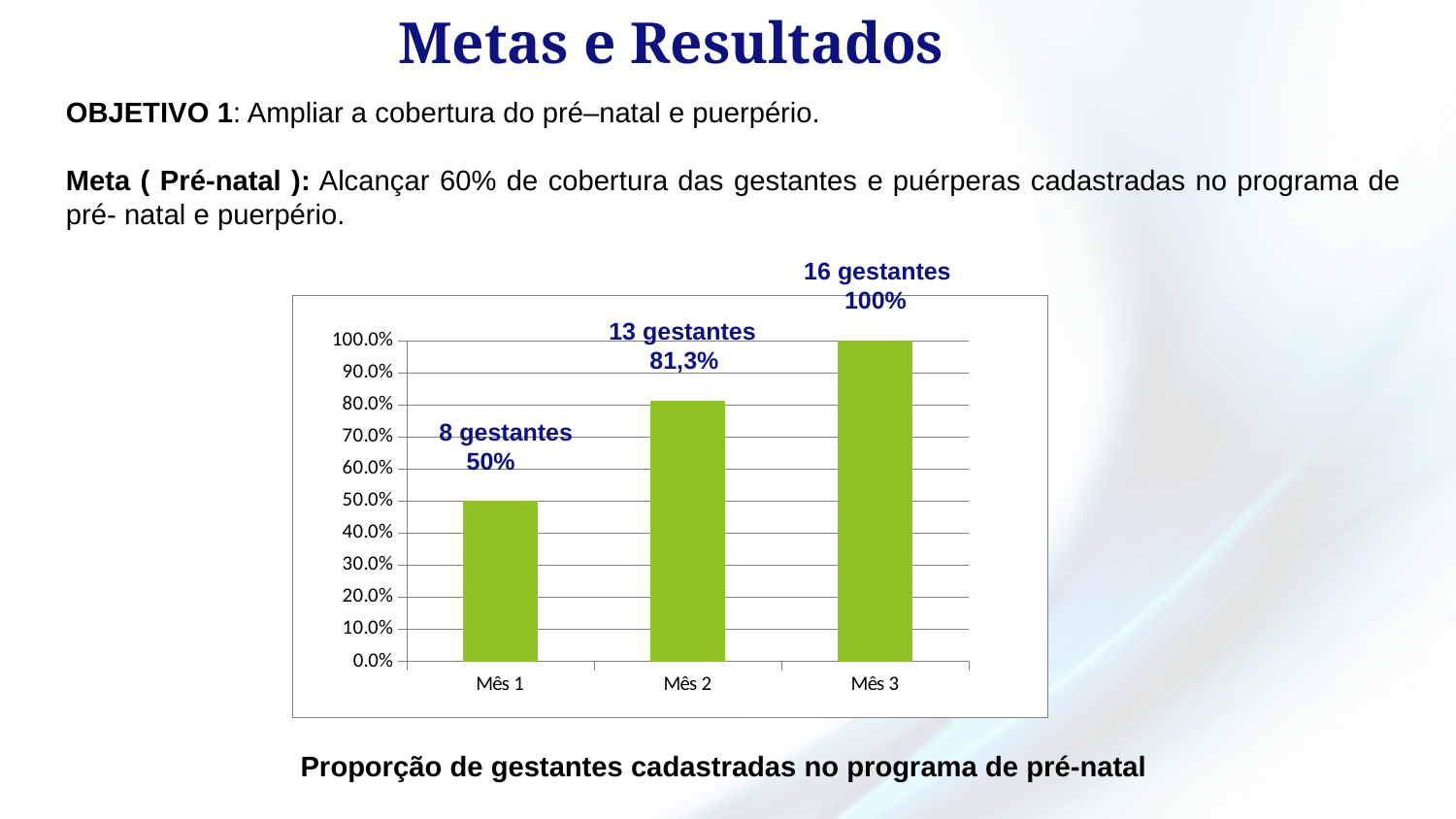
What is the difference in percentage points between Mês 3 and Mês 1? 50 Do the values rise or fall from Mês 1 to Mês 3? rise How many gestantes are labelled for Mês 2? 13 gestantes What is the value for Mês 2? 81,3% What is the value for Mês 3? 100% Which month has the lowest value? Mês 1 Which month has the highest value? Mês 3 Is the value for Mês 2 greater or less than 60.0%? greater What kind of chart is shown on the slide? bar chart Which is larger, the value for Mês 2 or the value for Mês 1? Mês 2 How many bars are shown in the chart? 3 What is the value for Mês 1? 50%